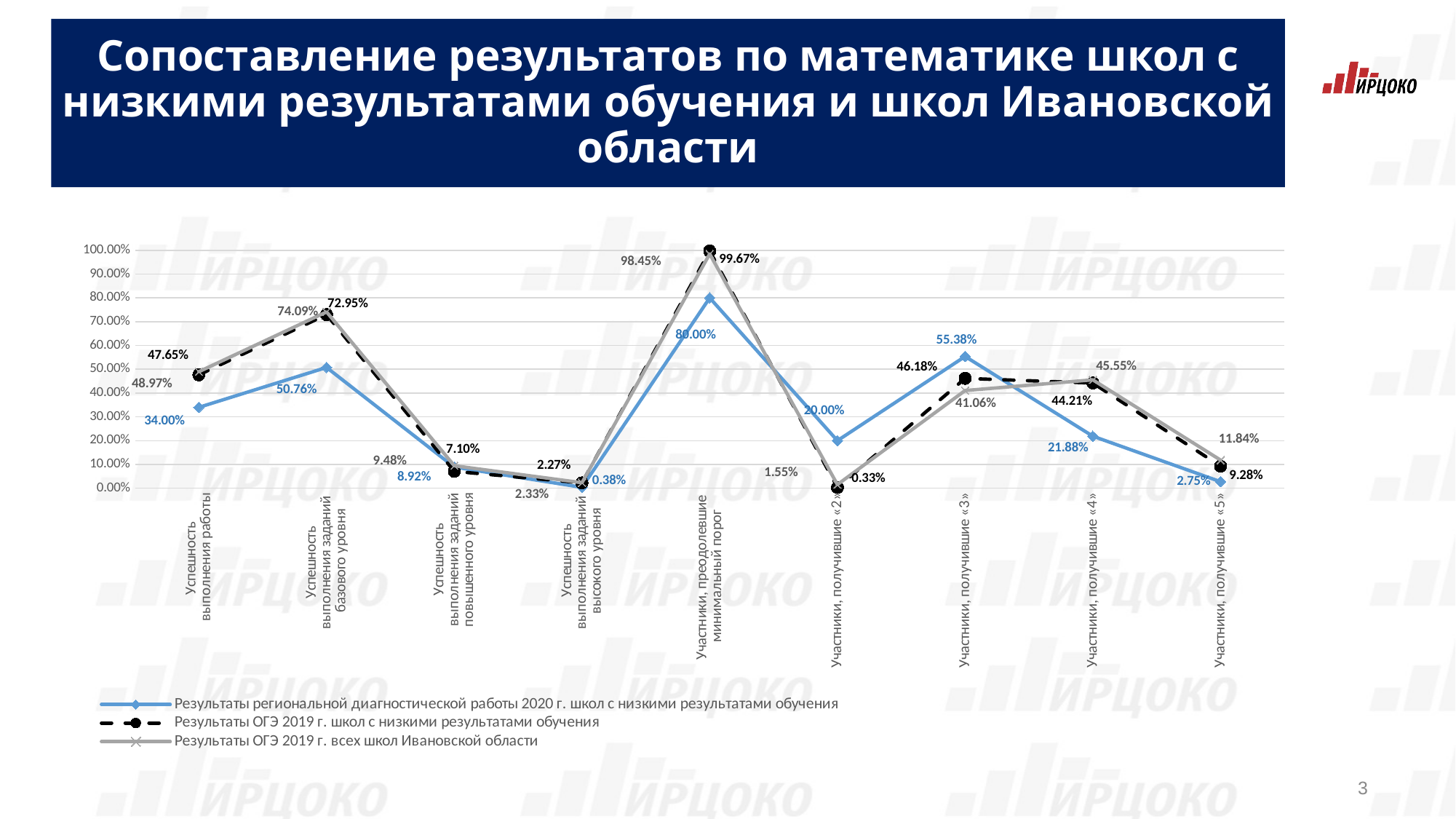
What is the value of the 2020 regional diagnostic work series (Результаты региональной диагностической работы 2020 г.) for «Участники, преодолевшие минимальный порог»? 80.00% How many series does the legend list? 3 For «Участники, получившие «3»», which is larger: the 2020 regional diagnostic work value or the ОГЭ 2019 value for schools with low results? The 2020 regional diagnostic work value (55.38%) What is the difference between the ОГЭ 2019 value for schools with low results (99.67%) and the 2020 regional diagnostic value (80.00%) for «Участники, преодолевшие минимальный порог»? 19.67 percentage points What is the value of the ОГЭ 2019 series for schools with low results (Результаты ОГЭ 2019 г. школ с низкими результатами обучения) for «Участники, получившие «3»»? 46.18% What is the value of the ОГЭ 2019 series for all schools of the Ivanovo region for «Успешность выполнения заданий базового уровня»? 74.09% Is the 2020 regional diagnostic work value for «Успешность выполнения работы» greater or less than 40%? less How many categories are plotted along the x axis? 9 What colour is the line for the 2020 regional diagnostic work series (Результаты региональной диагностической работы 2020 г.)? Blue For which category does the 2020 regional diagnostic work series reach its highest value? Участники, преодолевшие минимальный порог For which category does the 2020 regional diagnostic work series have its lowest value? Успешность выполнения заданий высокого уровня What kind of chart is shown on the slide? Line chart